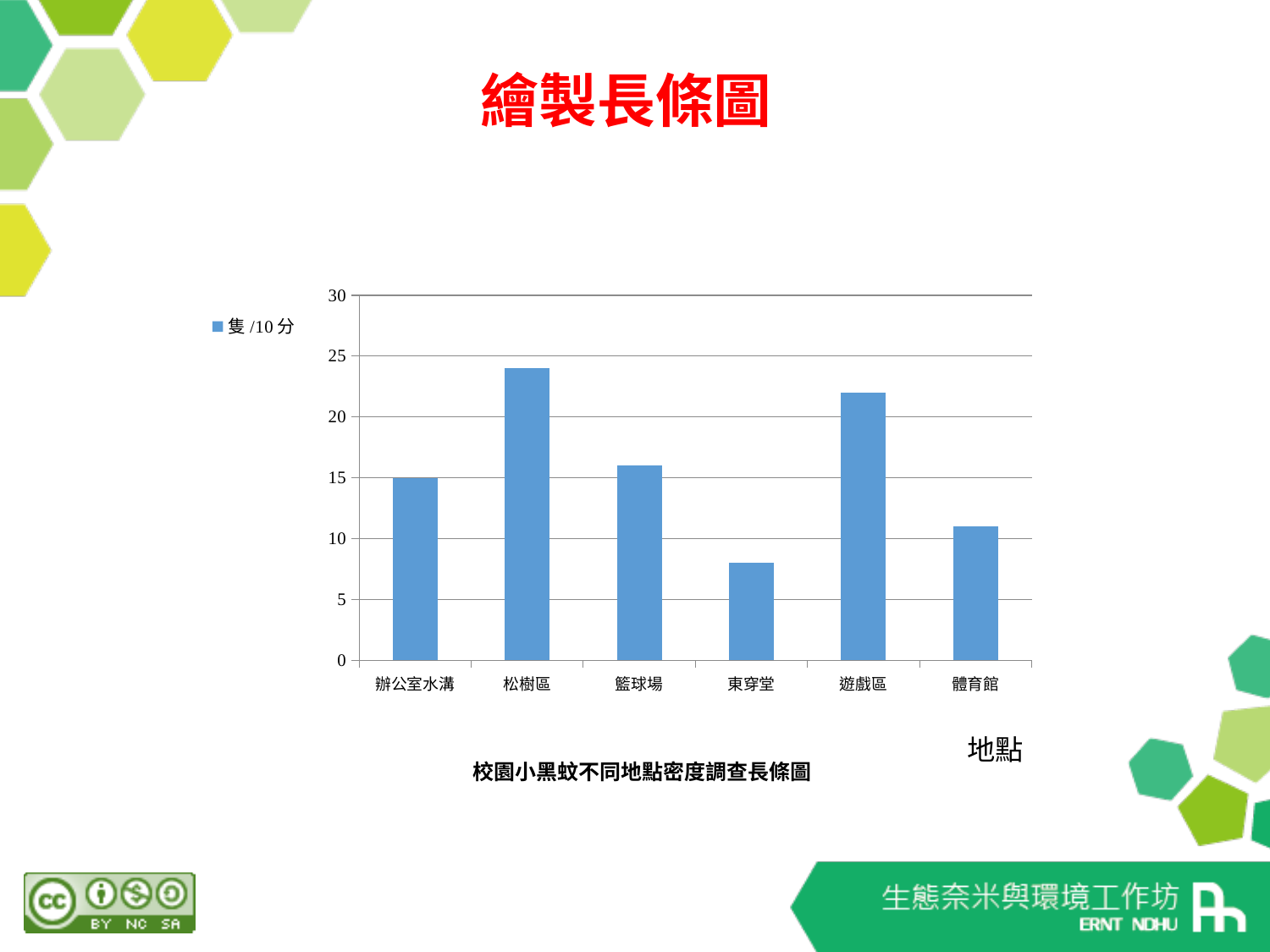
How many series does the chart legend list? 1 Which location has the lowest value in the chart? 東穿堂 Is the value for 遊戲區 greater or less than 25? less What is the legend entry (series name) shown in the chart? 隻 /10 分 How many locations (categories) are shown on the x axis of the chart? 6 What kind of chart is shown on the slide? bar chart Which location has the highest value in the chart? 松樹區 Which has a larger value, 遊戲區 or 籃球場? 遊戲區 Is the value for 東穿堂 greater or less than 10? less Is the value for 體育館 greater or less than 10? greater What is the title printed below the chart? 校園小黑蚊不同地點密度調查長條圖